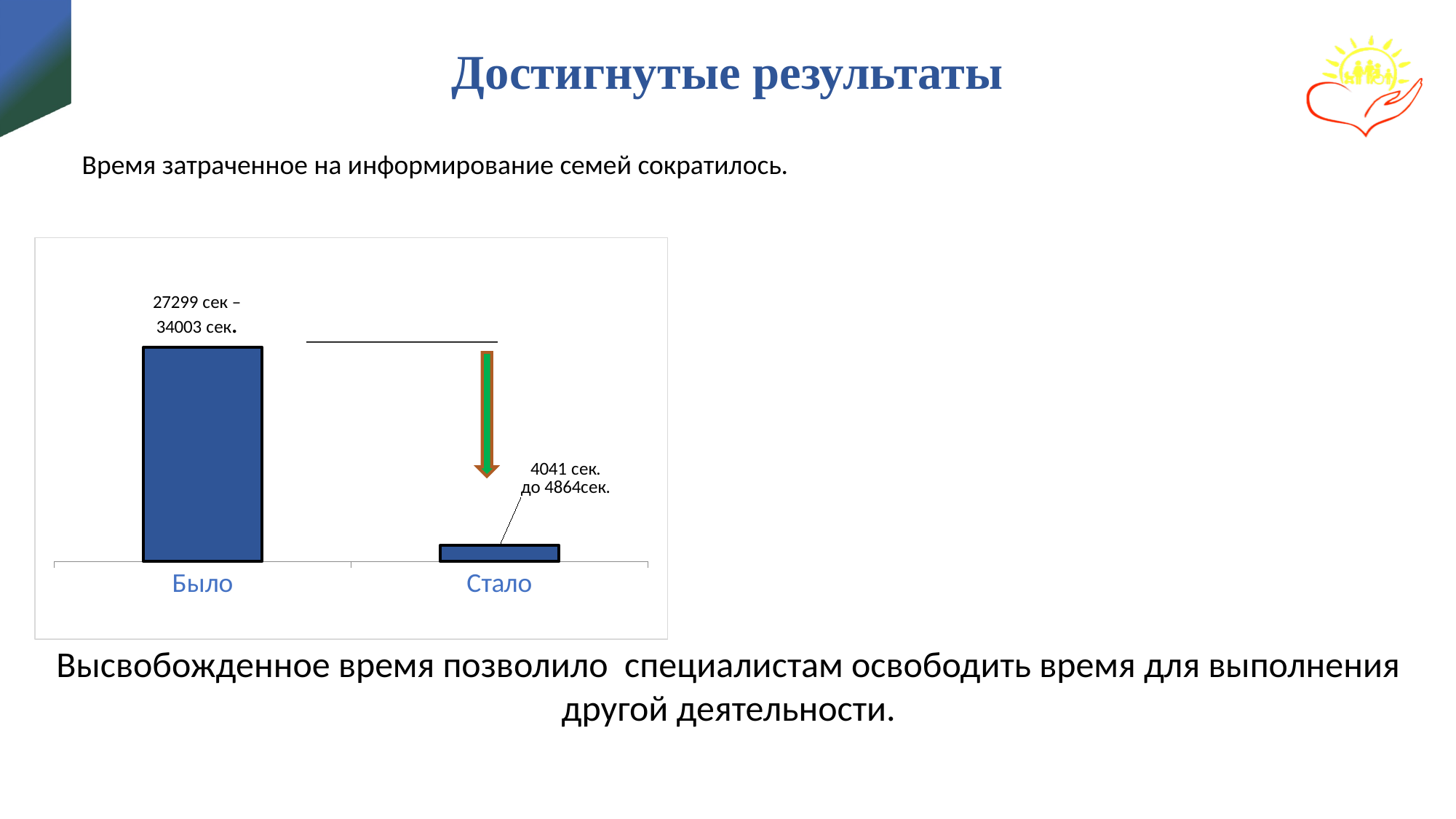
How many categories are shown on the x axis of the chart? 2 Do the values rise or fall from Было to Стало? fall What is the name of the first category on the x axis? Было What label is printed above the bar for Было? 27299 сек – 34003 сек. Which category has the lowest value in the chart? Стало What label is printed for the bar Стало? 4041 сек. до 4864сек. What colour are the bars in the chart? blue What kind of chart is shown on the slide? bar chart Which category has the taller bar, Было or Стало? Было Which category has the highest value in the chart? Было